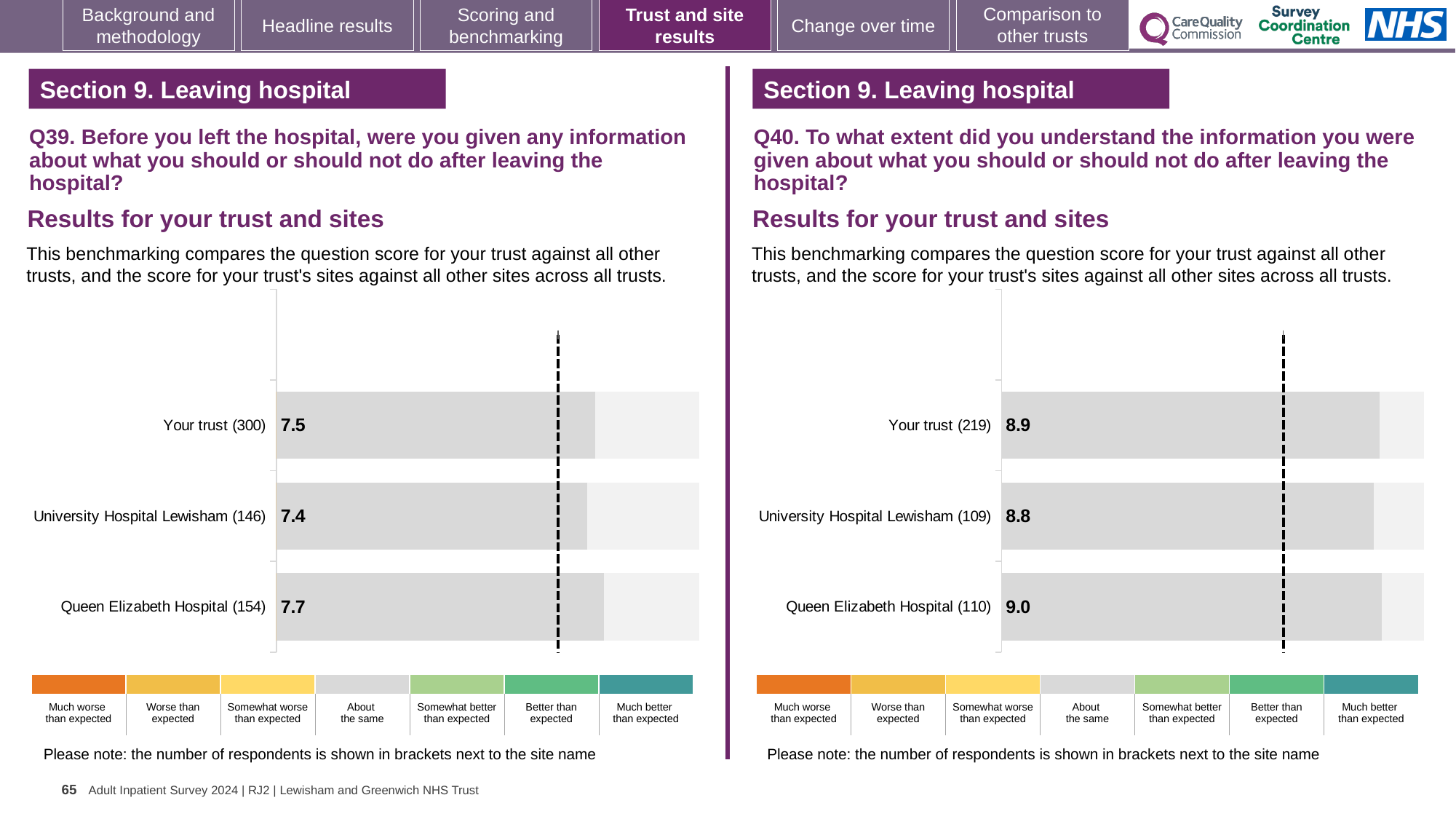
In the Q40 chart on the right, what is the score for University Hospital Lewisham? 8.8 In the Q39 chart on the left, which site or trust has the highest score? Queen Elizabeth Hospital In the Q39 chart on the left, what is the score for Queen Elizabeth Hospital? 7.7 In the Q39 chart on the left, which has the larger score, Your trust or University Hospital Lewisham? Your trust In the Q39 chart on the left, what is the difference between the scores for Queen Elizabeth Hospital and University Hospital Lewisham? 0.3 In the Q39 chart on the left, how many respondents are shown in brackets for Your trust? 300 In the Q39 chart on the left, what is the score for Your trust? 7.5 In the Q40 chart on the right, which site or trust has the lowest score? University Hospital Lewisham In the Q40 chart on the right, what is the difference between the scores for Your trust and University Hospital Lewisham? 0.1 How many bars are plotted in the Q40 chart on the right? 3 In the Q40 chart on the right, what is the score for Queen Elizabeth Hospital? 9.0 What type of chart is used in the Q39 chart on the left? Bar chart